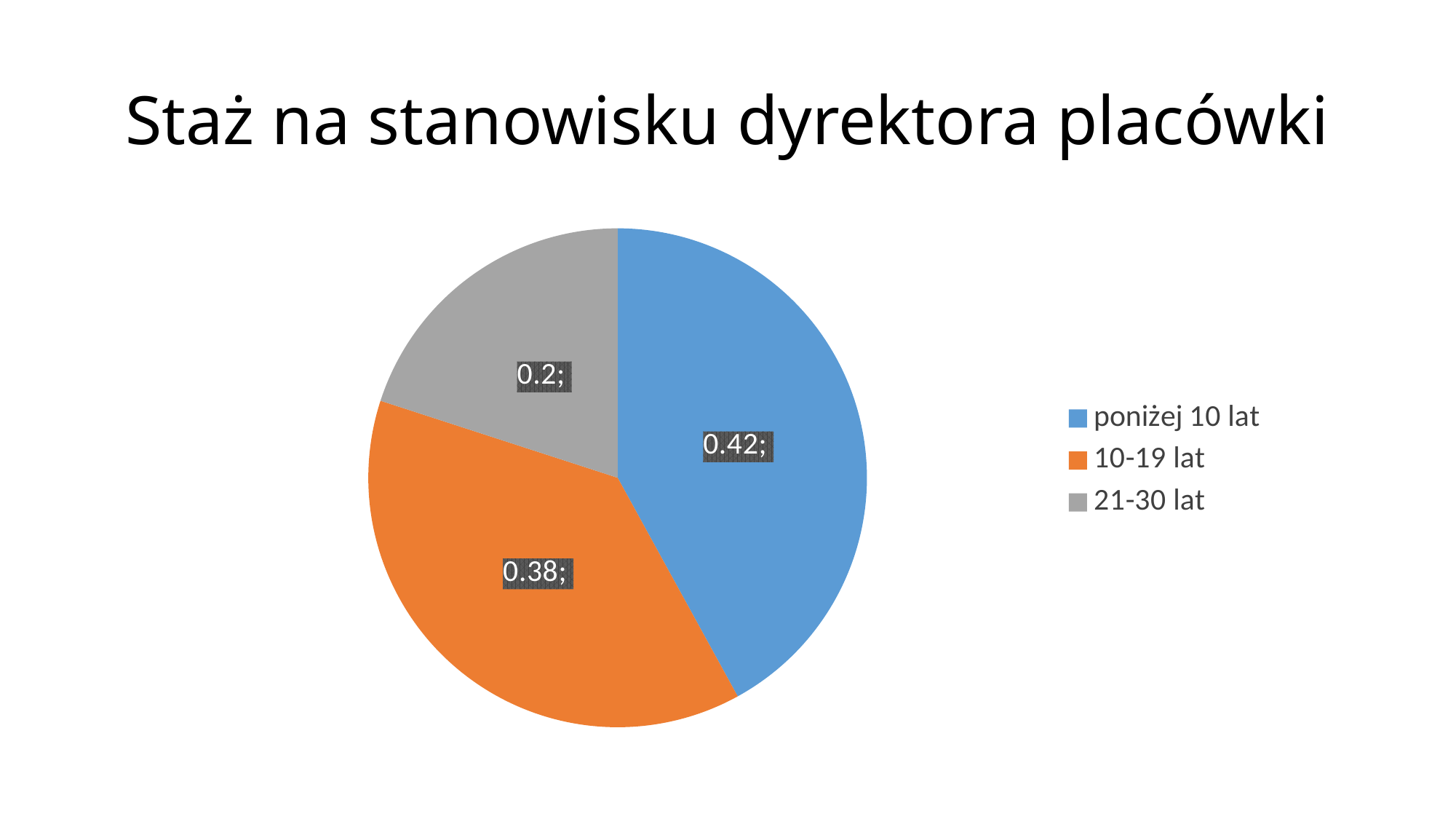
What is the value shown for the 'poniżej 10 lat' slice? 0.42 What is the difference between the values for '10-19 lat' and '21-30 lat'? 0.18 Which is larger, the slice for '10-19 lat' or the slice for '21-30 lat'? 10-19 lat What colour is the slice for '10-19 lat'? orange Which category has the largest slice of the pie? poniżej 10 lat What is the value shown for the '21-30 lat' slice? 0.2 What is the difference between the values for 'poniżej 10 lat' and '21-30 lat'? 0.22 Which category has the smallest slice of the pie? 21-30 lat What is the title of the chart? Staż na stanowisku dyrektora placówki How many categories does the pie chart have? 3 What kind of chart is shown on the slide? pie chart What is the value shown for the '10-19 lat' slice? 0.38